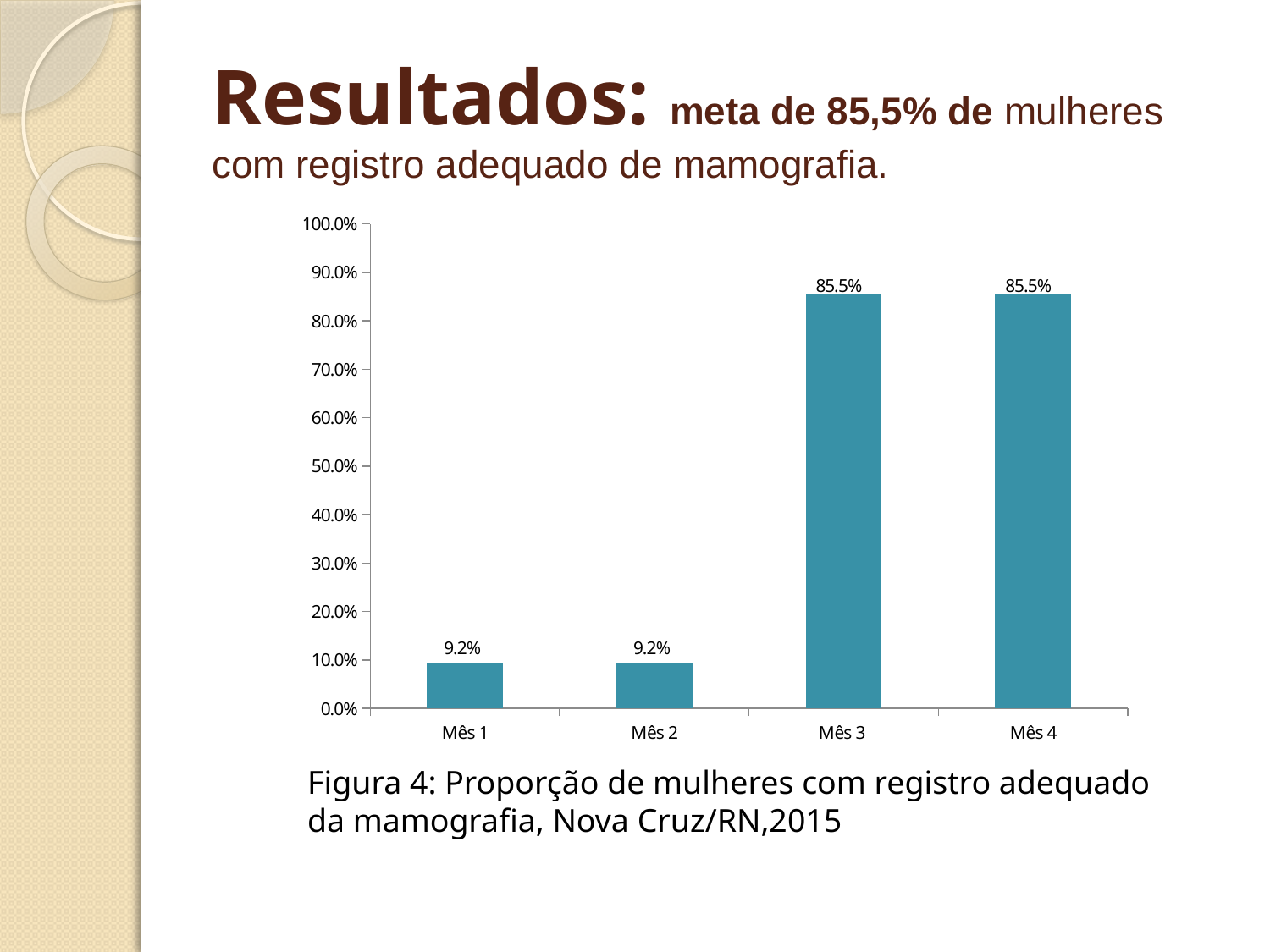
What is the figure caption below the chart? Figura 4: Proporção de mulheres com registro adequado da mamografia, Nova Cruz/RN,2015 Do the values rise or fall from Mês 1 to Mês 4? rise How many categories are shown on the x axis? 4 Is the value for Mês 2 greater or less than 10.0%? less Is the value for Mês 3 greater or less than 80.0%? greater What is the value for Mês 4? 85.5% What kind of chart is shown on the slide? bar chart What is the difference between the values for Mês 3 and Mês 2? 76.3% Which is larger, the value for Mês 2 or the value for Mês 4? Mês 4 What is the value for Mês 3? 85.5% What is the value for Mês 1? 9.2% Do Mês 1 and Mês 2 have the same value? Yes